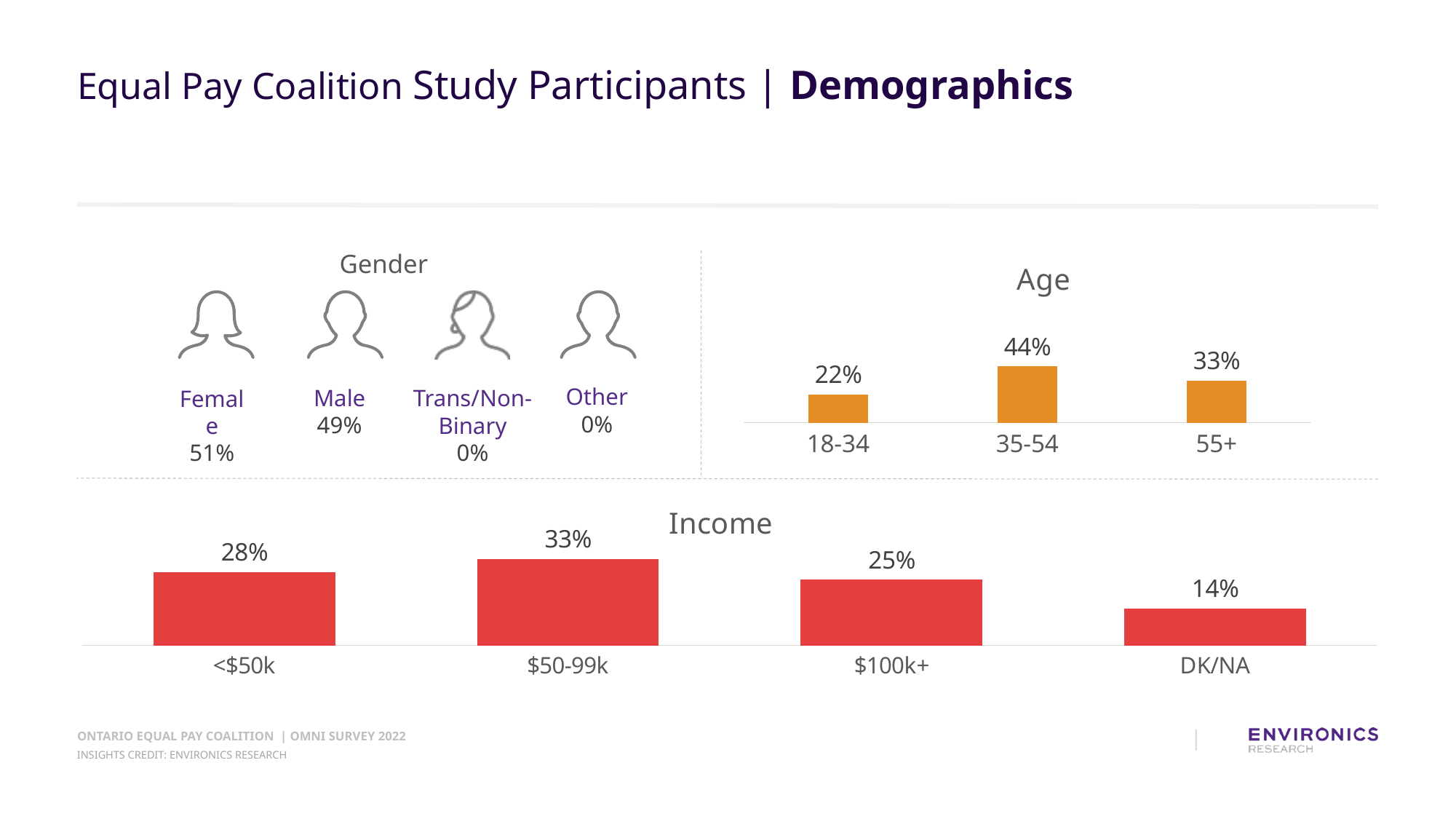
In the Age chart, what percentage of participants are aged 35-54? 44% In the Age chart, which age group has the lowest share of participants? 18-34 In the Income chart, what is the difference between the <$50k and $100k+ values? 3% In the Income chart, what percentage of participants earn $100k+? 25% In the Income chart, how many income categories are shown? 4 In the Age chart, what is the difference between the 35-54 and 55+ values? 11% In the Income chart, which income category has the lowest value? DK/NA In the Age chart, what is the value for the 18-34 group? 22% In the Income chart, what is the value for DK/NA? 14% In the Age chart, which age group has the highest share of participants? 35-54 What type of chart is the Age chart? Bar chart In the Income chart, which income category has the highest value? $50-99k